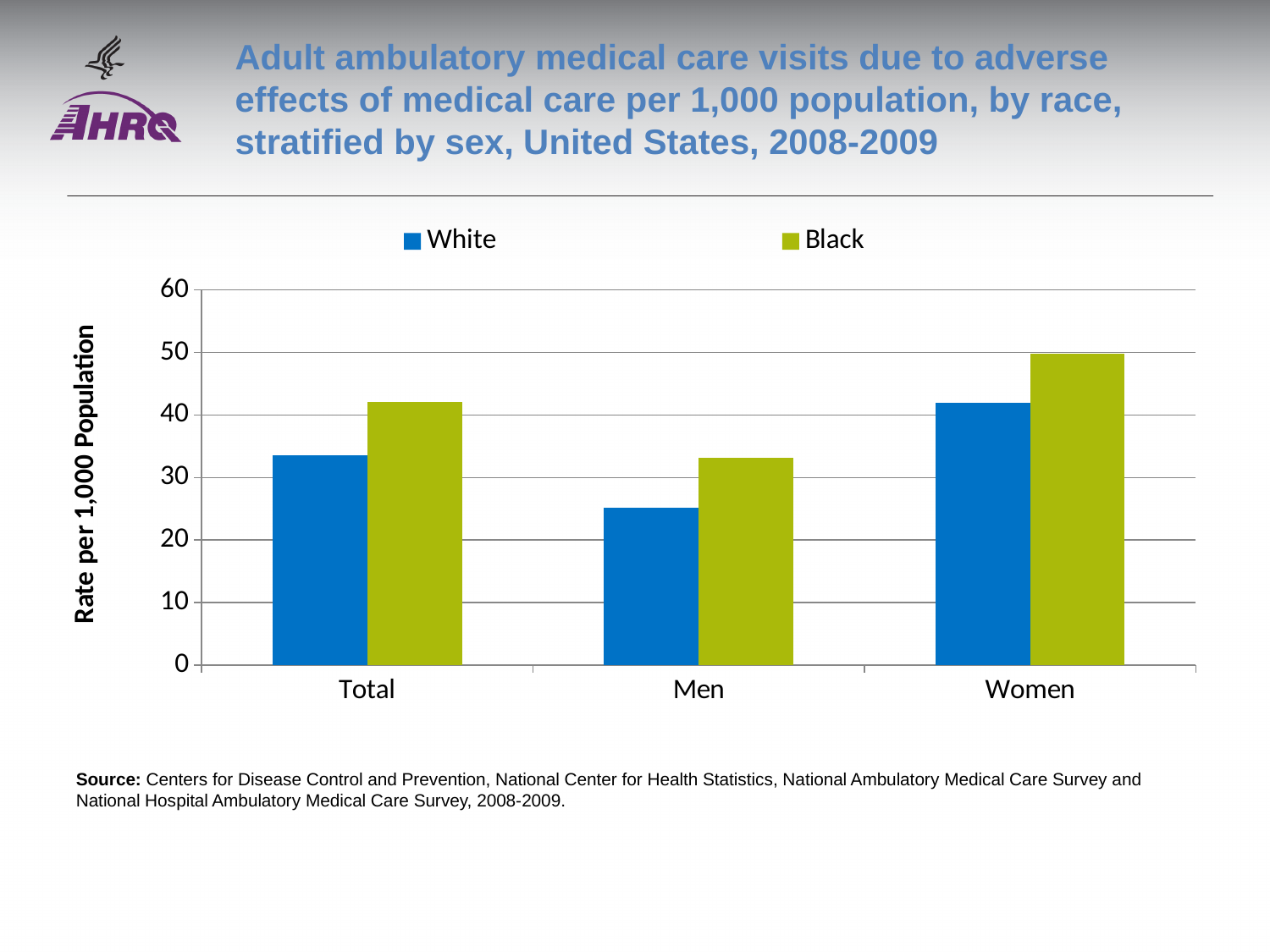
Which category has the highest value for the Black series? Women Which category has the lowest value for the White series? Men Which is larger for Men: the White value or the Black value? Black Is the value for White in the Men category greater or less than 30? less Which series is shown in green? Black How many categories are shown on the x axis? 3 Is the value for Black in the Total category greater or less than 40? greater Is the value for White in the Women category greater or less than 40? greater What kind of chart is shown on the slide? bar chart Which is larger: the White value for Women or the White value for Total? Women How many series does the legend list? 2 What is the label on the y axis? Rate per 1,000 Population